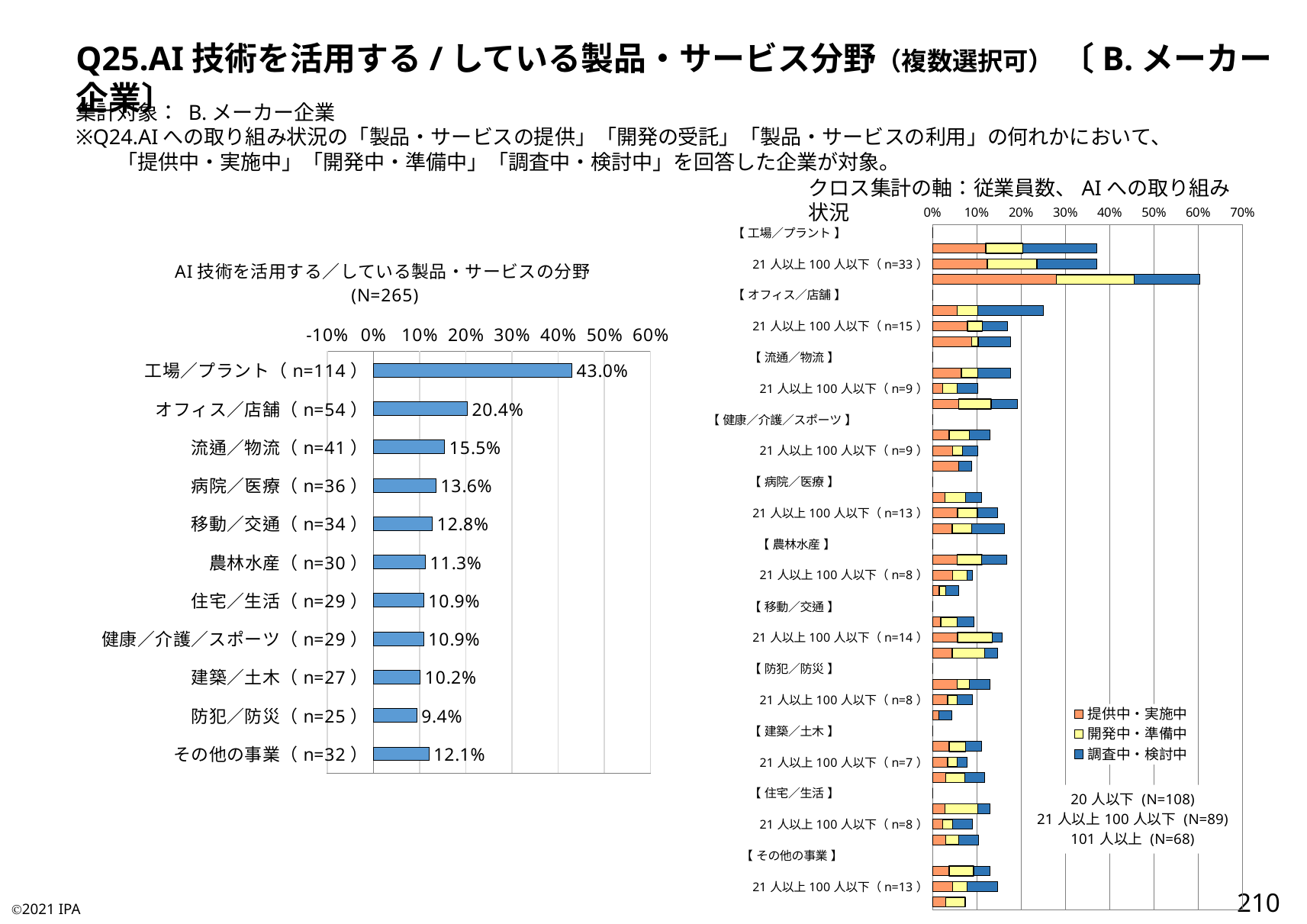
In the right stacked chart (クロス集計), how many series does the legend list? 3 In the left chart (N=265), which is larger, the value for 流通／物流 or the value for 病院／医療? 流通／物流 In the left chart (N=265), which category has the lowest value? 防犯／防災 In the left chart (N=265), how many categories are plotted? 11 In the left chart (N=265), what is the difference between the values for 工場／プラント and オフィス／店舗? 22.6% In the right stacked chart (クロス集計), which series is shown in orange according to the legend? 提供中・実施中 In the left chart (N=265), which category has the highest value? 工場／プラント In the left chart titled 'AI技術を活用する／している製品・サービスの分野 (N=265)', what is the value for 工場／プラント? 43.0% What kind of chart is the left chart (N=265)? Bar chart In the right stacked chart (クロス集計), is the total for the 101人以上 bar in the 工場／プラント group greater or less than 50%? greater In the left chart (N=265), what is the value for オフィス／店舗? 20.4% In the left chart (N=265), what is the value for その他の事業? 12.1%